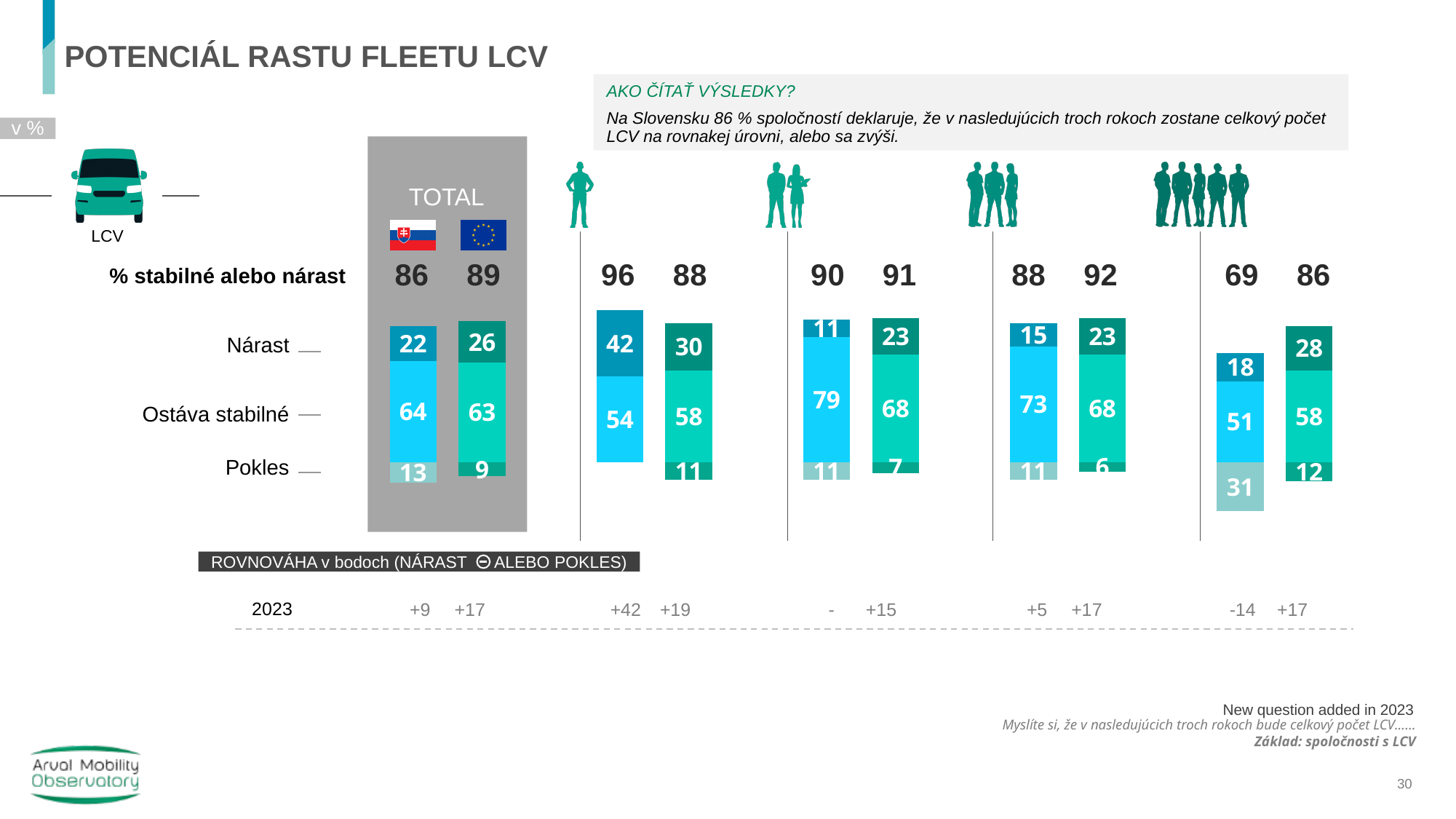
In the TOTAL block, what is the Pokles value for Slovakia? 13 What is the '% stabilné alebo nárast' figure for Slovakia in the TOTAL block? 86 Among the EU bars, which segment has the lowest Pokles value? The third segment (three-person icon), 6 How many categories make up each stacked bar? 3 What kind of chart is used to show Nárast, Ostáva stabilné and Pokles? Stacked bar chart In the TOTAL block, by how many points does the EU '% stabilné alebo nárast' figure exceed the Slovak one? 3 In the TOTAL block, which has the larger Nárast value, Slovakia or the EU? EU Across the four segments to the right of the TOTAL block, which segment has the highest Slovak Nárast value? The first segment (single-person icon), 42 In the TOTAL block, what is the Ostáva stabilné value for the EU (EU flag)? 63 In the TOTAL block, what is the Nárast value for Slovakia (Slovak flag)? 22 What is the ROVNOVÁHA (balance) value for Slovakia in the rightmost segment (five-person icon)? -14 In the rightmost segment (five-person icon), what is the Pokles value for the Slovak bar? 31